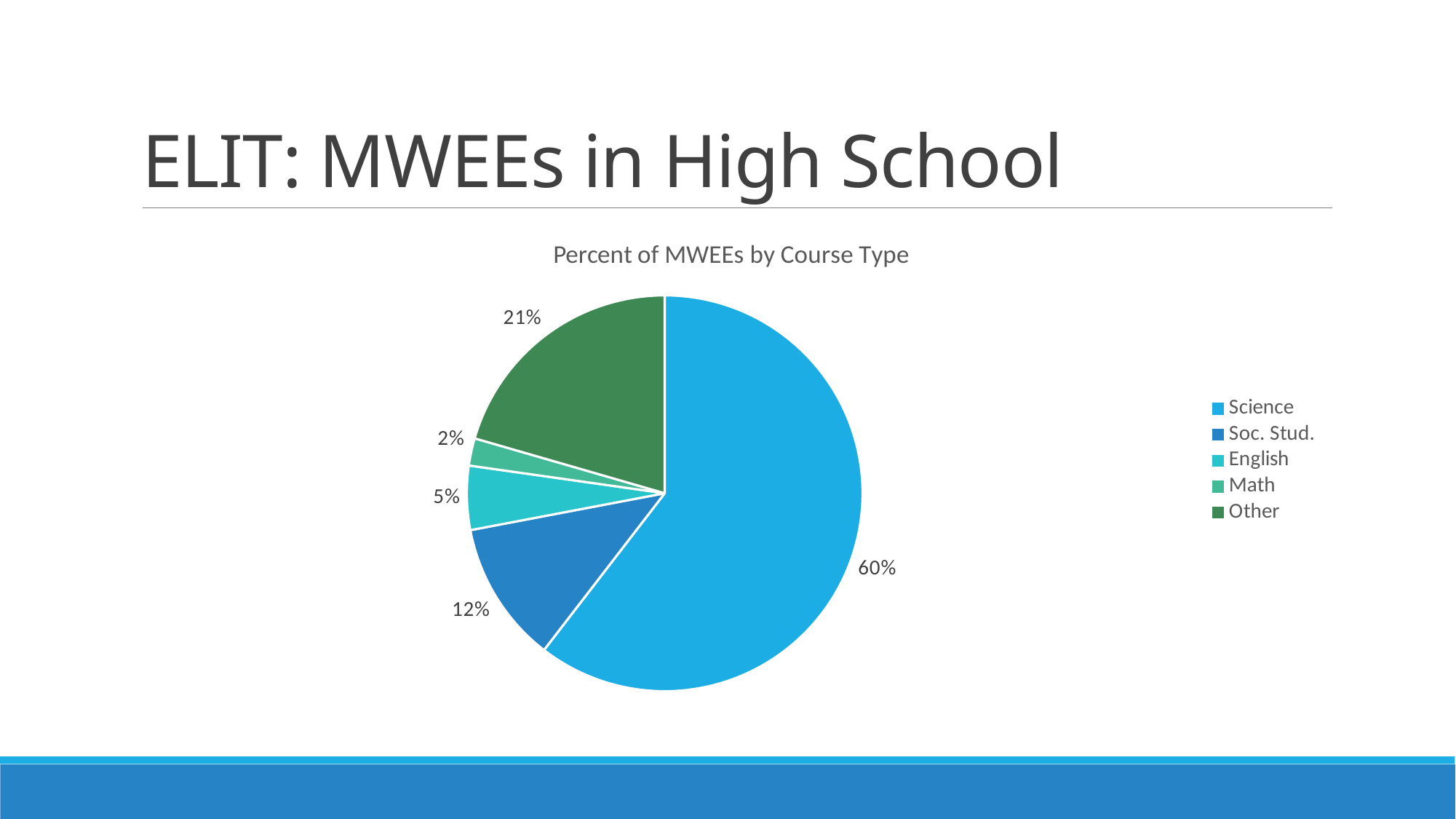
Which course type has the largest share of MWEEs? Science What kind of chart is shown on the slide? Pie chart Which course type has the smallest share of MWEEs? Math What percentage of MWEEs fall under Other? 21% What percentage of MWEEs are in Math courses? 2% What percentage of MWEEs are in Soc. Stud. courses? 12% How many percentage points larger is the Science share than the Other share? 39 What percentage of MWEEs are in English courses? 5% Which has a larger share of MWEEs, Soc. Stud. or English? Soc. Stud. How many course types are shown in the pie chart? 5 What is the title of the chart? Percent of MWEEs by Course Type What percentage of MWEEs are in Science courses? 60%